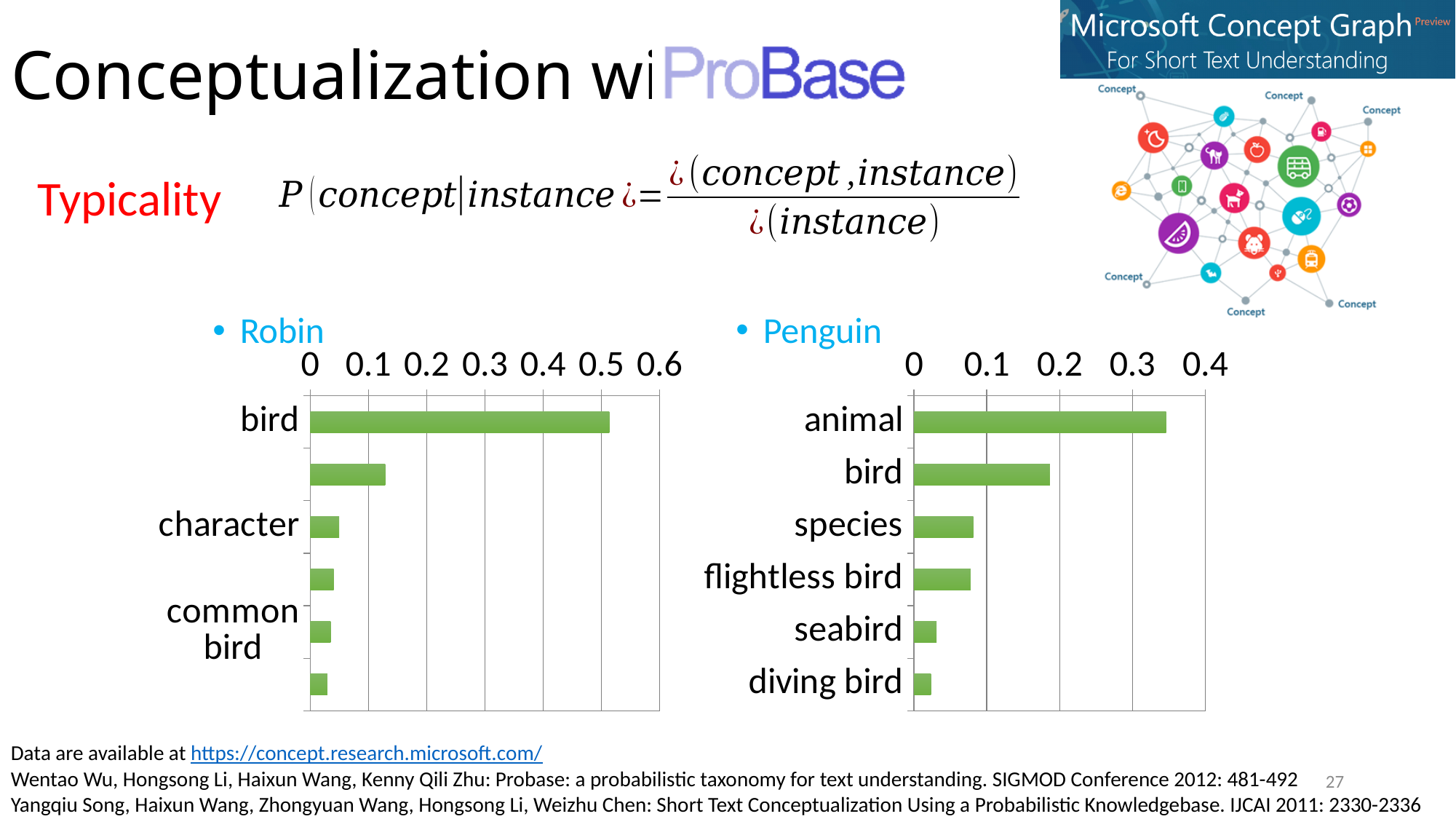
What is the largest tick value shown on the axis of the Penguin chart? 0.4 What kind of chart is the Robin chart? bar chart How many categories are shown in the Penguin chart? 6 In the Robin chart, is the value for character greater or less than 0.1? less In the Robin chart, which category has the highest value? bird In the Penguin chart, which is larger, the value for species or the value for seabird? species In the Penguin chart, is the value for animal greater or less than 0.3? greater In the Penguin chart, is the value for bird greater or less than 0.2? less In the Penguin chart, do the values rise or fall going from the top bar to the bottom bar? fall In the Penguin chart, which is larger, the value for animal or the value for bird? animal In the Penguin chart, which category has the highest value? animal